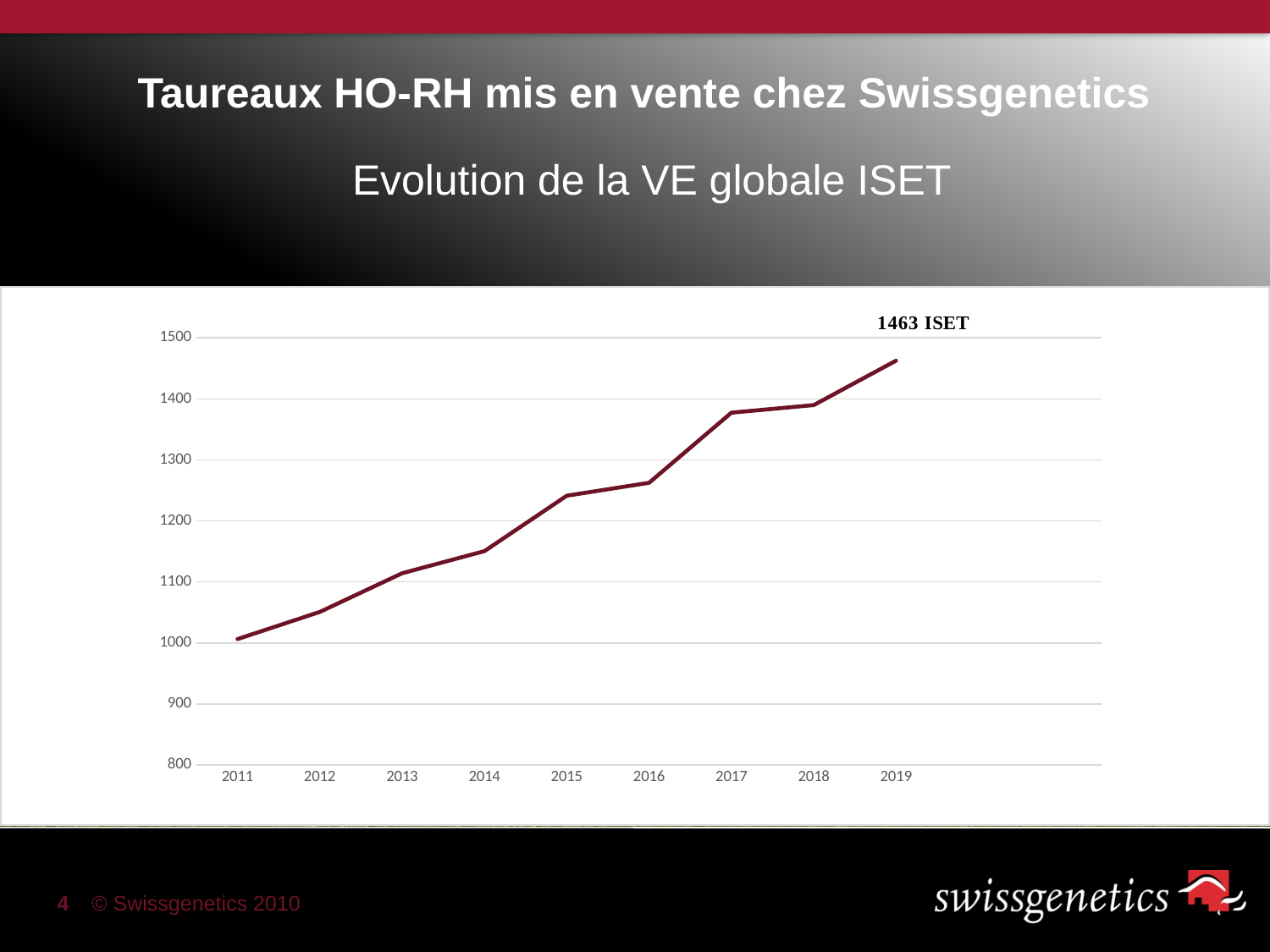
Which year has the larger value, 2014 or 2017? 2017 Is the value for 2011 greater or less than 1100? less Which year has the lowest value? 2011 Is the value for 2016 greater or less than 1300? less What kind of chart is shown on the slide? line chart Is the value for 2017 greater or less than 1400? less Do the values rise or fall from 2011 to 2019? rise How many years are plotted along the x axis? 9 What is the subtitle of the chart shown on the slide? Evolution de la VE globale ISET What value is labelled for 2019? 1463 ISET Which year has the highest value? 2019